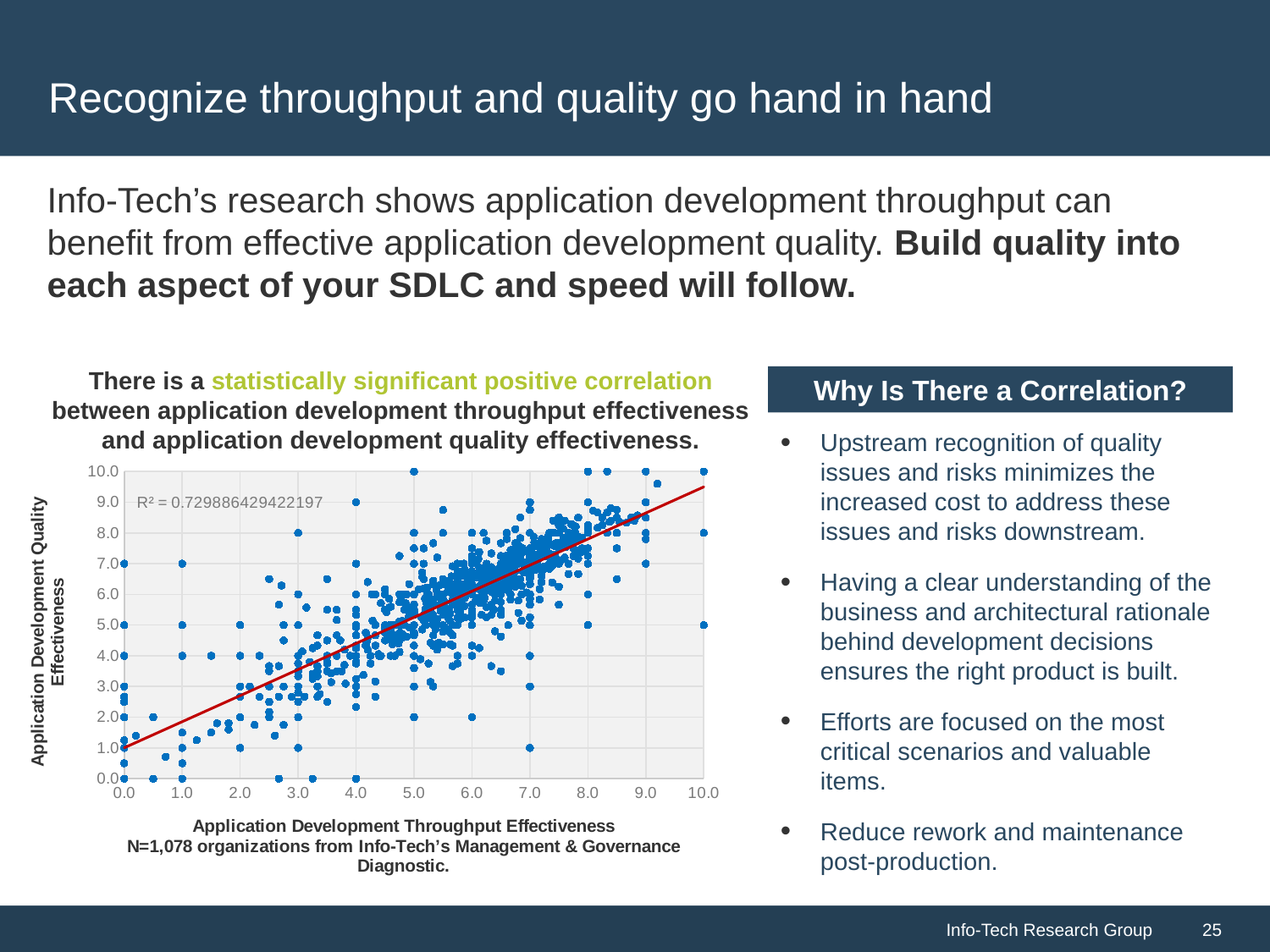
Do the plotted values of Application Development Quality Effectiveness rise or fall as Application Development Throughput Effectiveness increases along the x axis? rise What R² value is printed on the chart? R² = 0.729886429422197 What kind of chart is shown on the slide? scatter chart How many organizations are included in the data plotted on the chart? 1,078 At a throughput effectiveness of 10.0, is the value of the red trend line greater or less than 8.0? greater What is the title of the x axis of the chart? Application Development Throughput Effectiveness At a throughput effectiveness of 0.0, is the value of the red trend line greater or less than 2.0? less